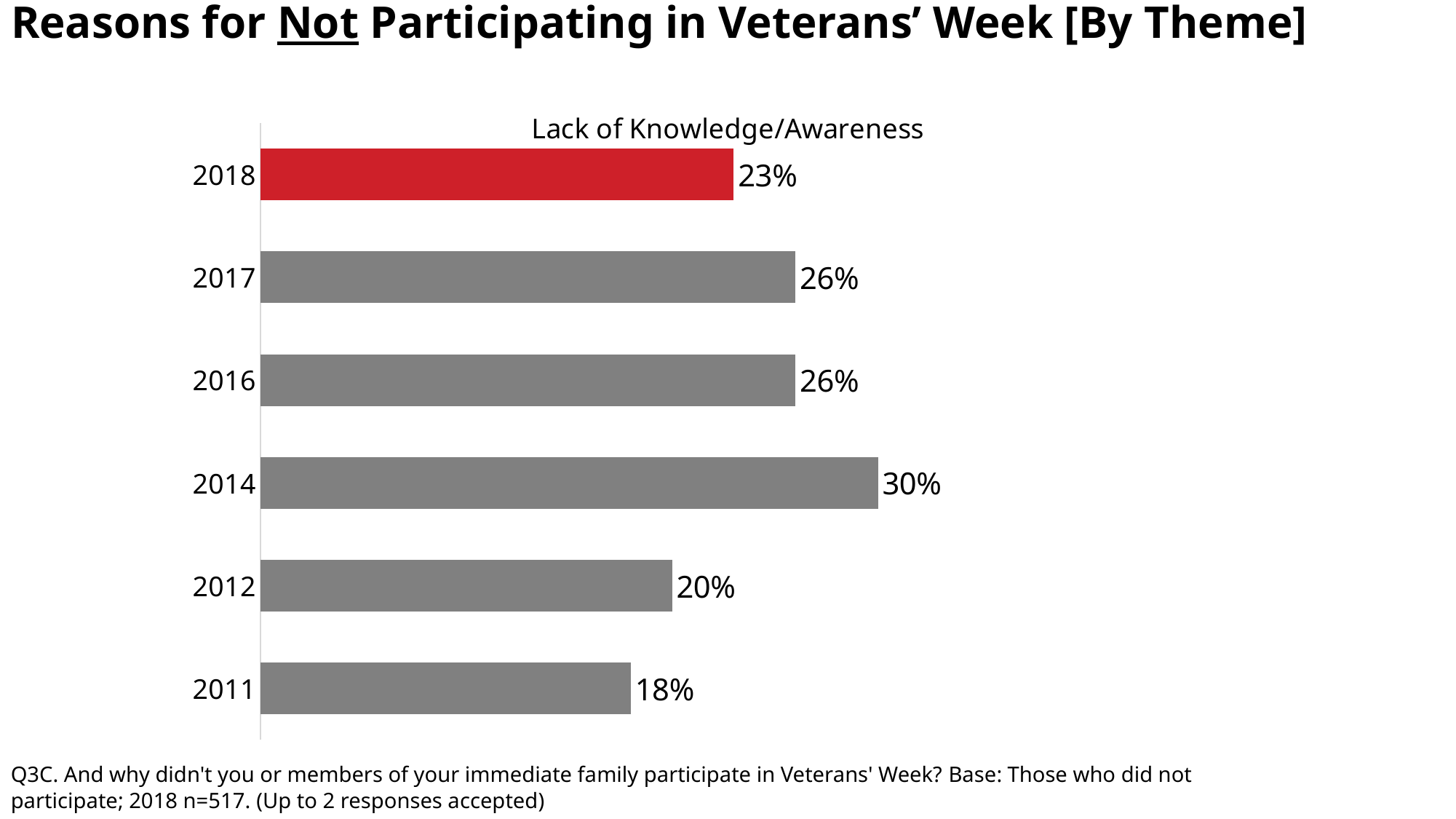
Which is larger, the value for 2017 or the value for 2018? 2017 How many years are shown in the chart? 6 What is the value for 2011? 18% Which year has the highest value? 2014 What is the value for 2018 in the Lack of Knowledge/Awareness chart? 23% Which year has the lowest value? 2011 What is the value for 2014? 30% Which year's bar is coloured red? 2018 What is the value for 2012? 20% What kind of chart is shown on the slide? Bar chart What is the difference between the values for 2014 and 2018? 7% What is the difference between the values for 2017 and 2011? 8%